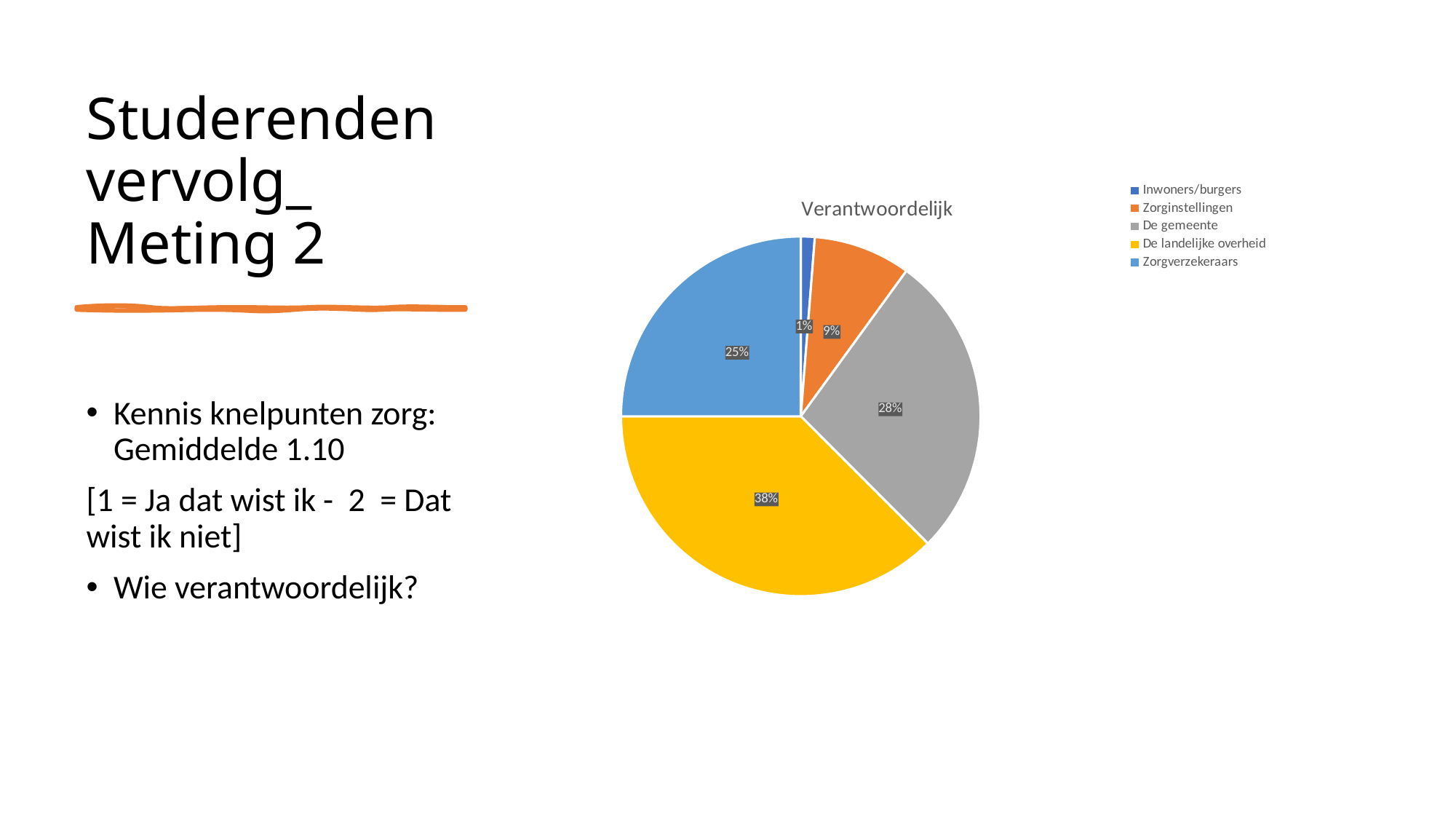
What share of the pie does Zorgverzekeraars have? 25% What is the title of the chart? Verantwoordelijk Which is larger, the share for De gemeente or the share for Zorgverzekeraars? De gemeente What share of the pie does De gemeente have? 28% What share of the pie does Zorginstellingen have? 9% What type of chart is shown on the slide? pie chart What is the difference in percentage points between De landelijke overheid and De gemeente? 10 Which category has the largest slice of the pie? De landelijke overheid How many categories does the legend list? 5 Which category has the smallest slice of the pie? Inwoners/burgers